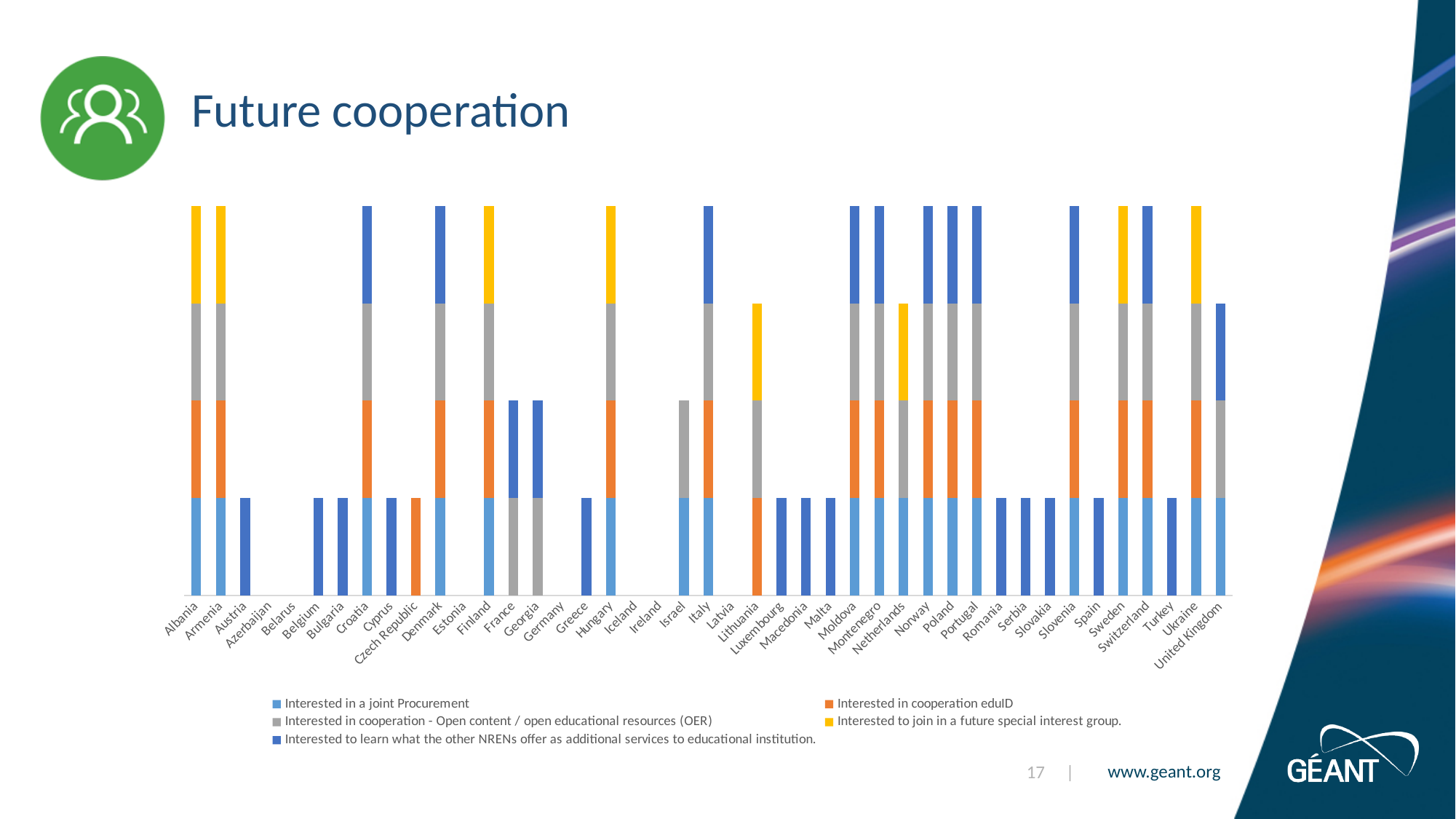
Which has the taller stacked bar, Albania or Austria? Albania How many series does the legend list? 5 How many countries are listed along the x axis of the chart? 43 What kind of chart is shown on the slide? Stacked bar chart What is the title of the slide containing the chart? Future cooperation Which has the taller stacked bar, United Kingdom or Ukraine? Ukraine Which series is shown in yellow in the legend? Interested to join in a future special interest group. Which has the taller stacked bar, Sweden or Turkey? Sweden